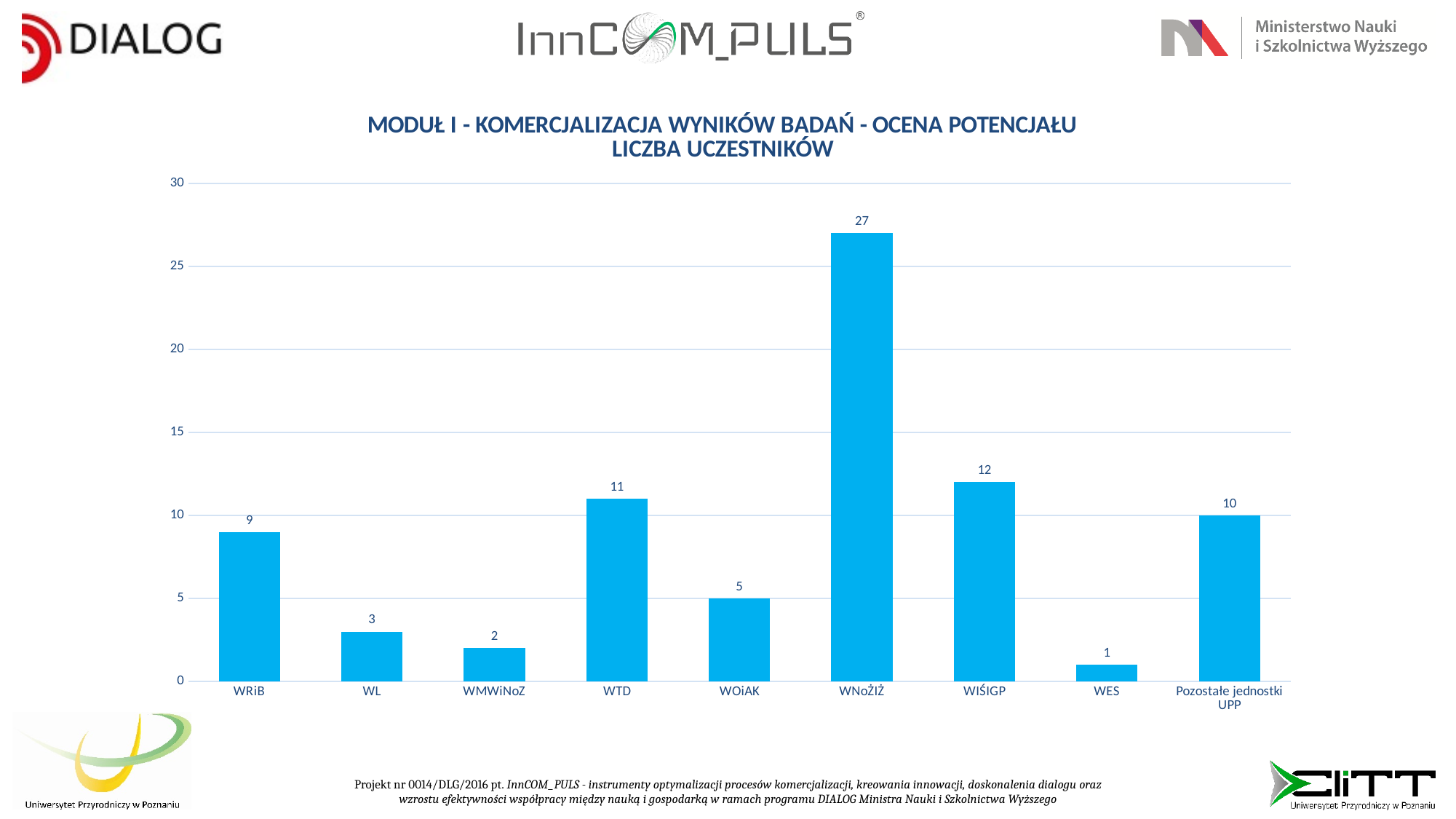
Is the value for WIŚiGP greater or less than 10? greater What is the value for WMWiNoZ? 2 What is the difference between the values for WTD and WRiB? 2 What is the difference between the values for WNoŻiŻ and WIŚiGP? 15 What is the value for Pozostałe jednostki UPP? 10 What is the title of the chart? MODUŁ I - KOMERCJALIZACJA WYNIKÓW BADAŃ - OCENA POTENCJAŁU LICZBA UCZESTNIKÓW What kind of chart is shown on the slide? bar chart What is the value for WNoŻiŻ? 27 Which category has the lowest value? WES Which is larger, the value for WOiAK or the value for WL? WOiAK Which category has the highest value? WNoŻiŻ How many categories are shown on the x axis? 9